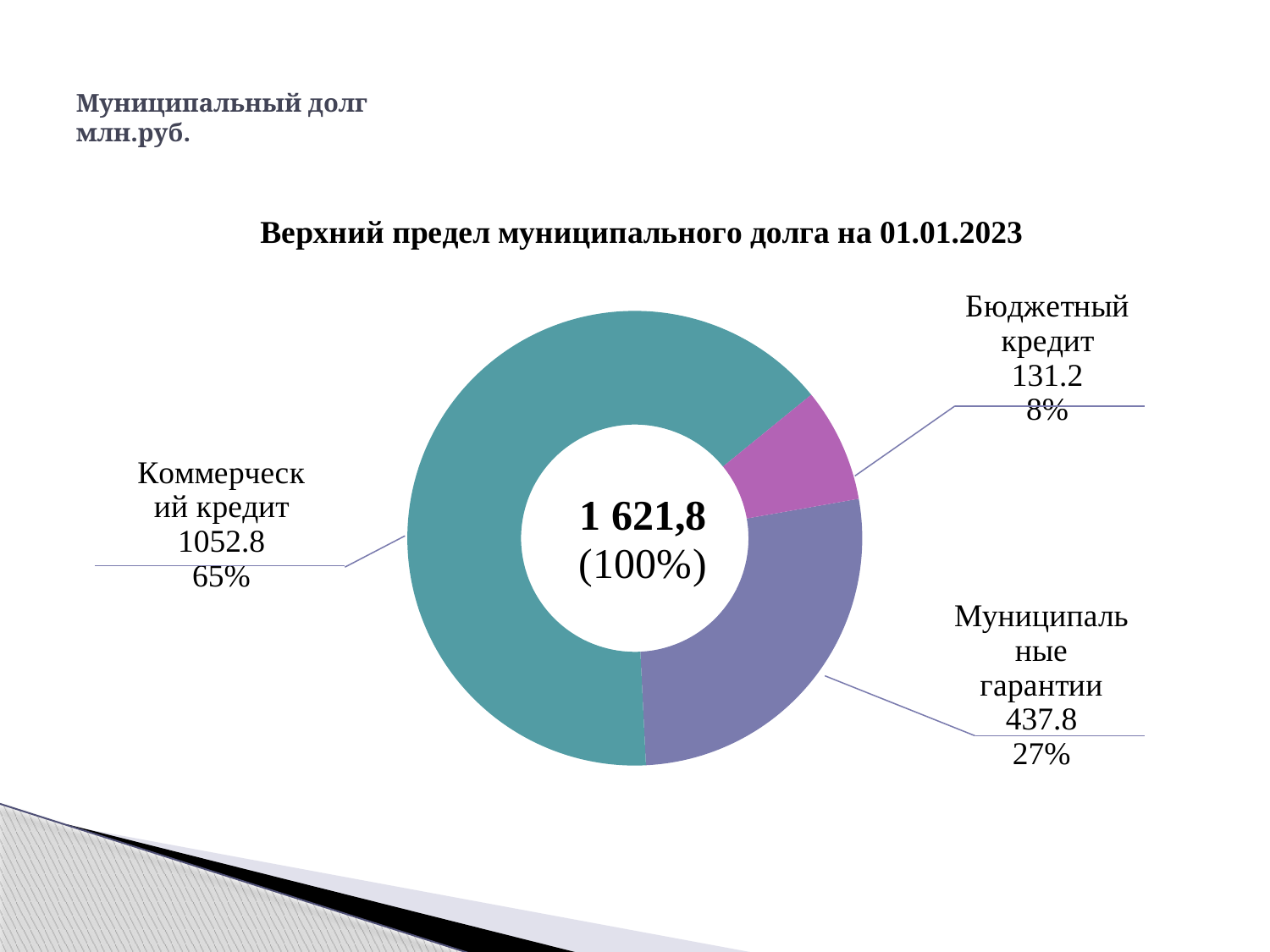
What kind of chart is shown on the slide? Doughnut (pie) chart What total value is shown in the centre of the chart? 1 621,8 What is the value for Бюджетный кредит? 131.2 What is the value for Коммерческий кредит? 1052.8 What is the difference between the values for Муниципальные гарантии and Бюджетный кредит? 306.6 How many categories are shown in the chart? 3 Which category has the largest value? Коммерческий кредит What share of the total does Коммерческий кредит represent? 65% Which category has the smallest value? Бюджетный кредит Which is larger, Муниципальные гарантии or Бюджетный кредит? Муниципальные гарантии What is the value for Муниципальные гарантии? 437.8 What share of the total does Муниципальные гарантии represent? 27%